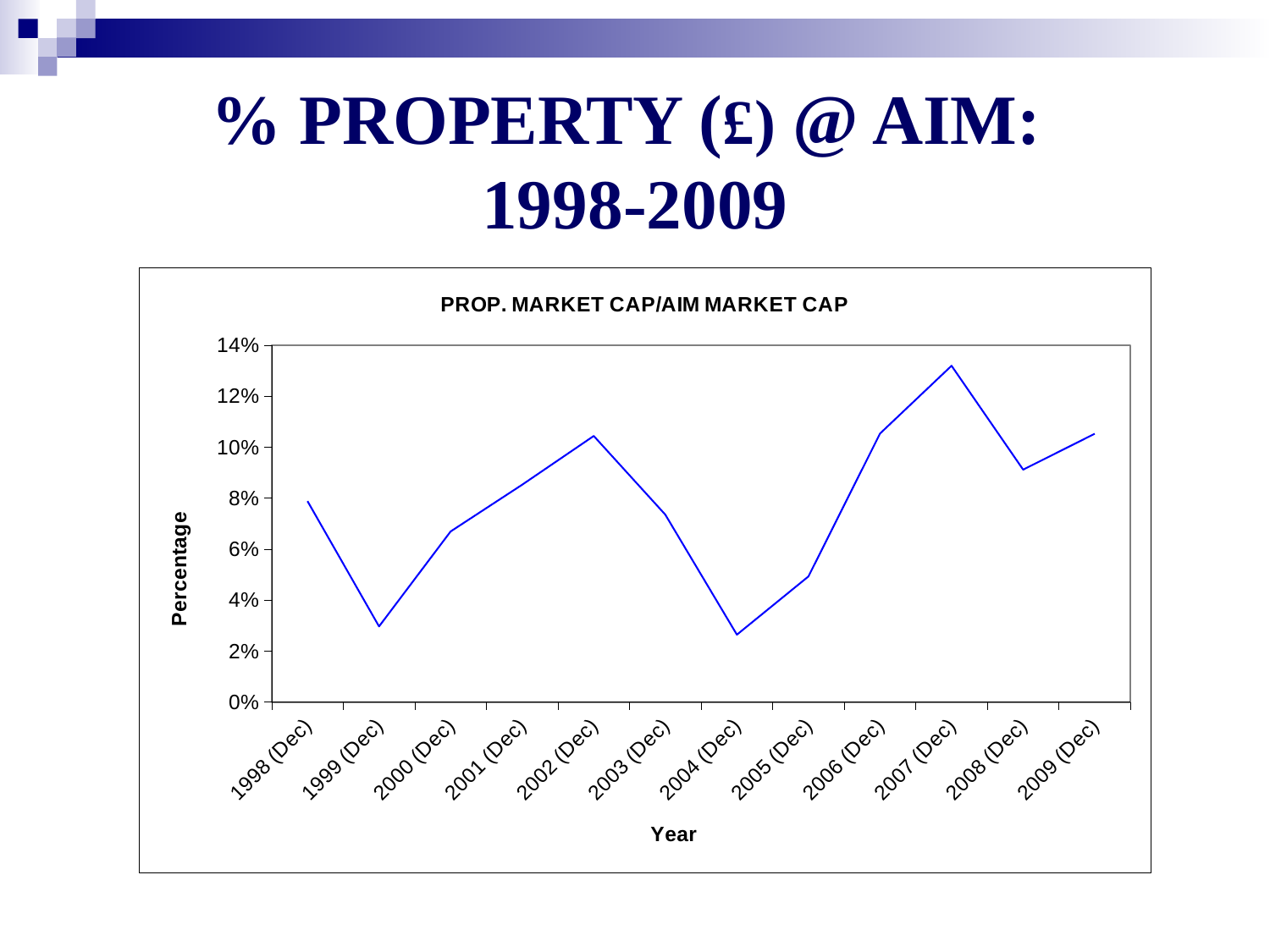
Do the values rise or fall from 2004 (Dec) to 2007 (Dec)? Rise Is the value for 2008 (Dec) greater or less than 10%? less How many data points (years) are plotted on the chart? 12 Is the value for 2007 (Dec) greater or less than 12%? greater Is the value for 2004 (Dec) greater or less than 4%? less Which is larger, the value for 2002 (Dec) or the value for 2003 (Dec)? 2002 (Dec) What kind of chart is shown on the slide? Line chart Which year has the highest percentage on the chart? 2007 (Dec) Which is larger, the value for 1999 (Dec) or the value for 2000 (Dec)? 2000 (Dec) What is the title printed inside the chart area? PROP. MARKET CAP/AIM MARKET CAP